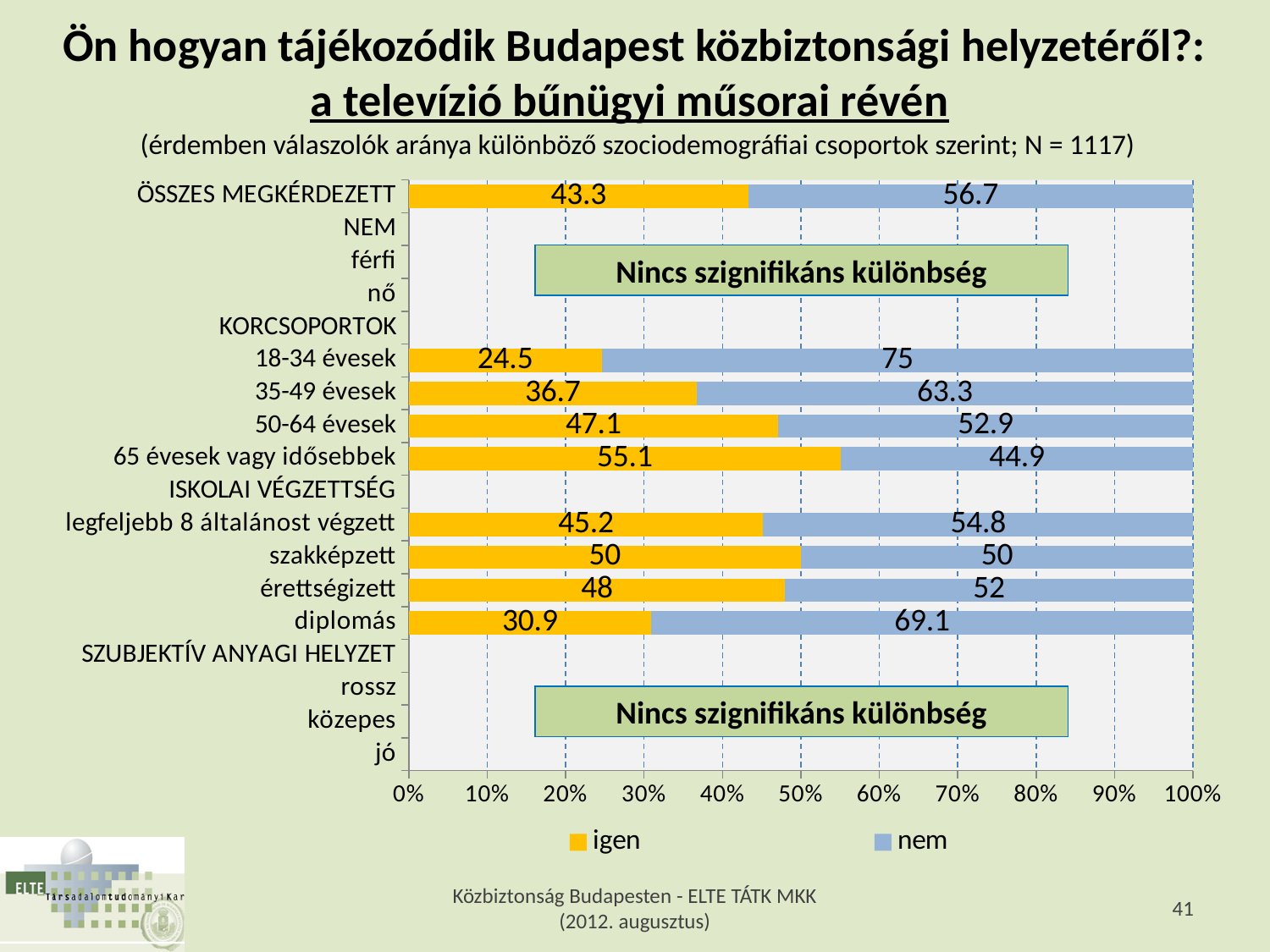
How many series does the legend list? 2 What is the "igen" value for ÖSSZES MEGKÉRDEZETT? 43.3 What is the "igen" value for diplomás? 30.9 Which is larger: the "igen" value for szakképzett or the "igen" value for érettségizett? szakképzett What kind of chart is shown on the slide? Stacked bar chart Among the education groups (ISKOLAI VÉGZETTSÉG), which has the lowest "igen" value? diplomás Is the "igen" value for 50-64 évesek greater or less than 40%? greater What is the "nem" value for 18-34 évesek? 75 What is the difference between the "nem" values for 18-34 évesek and 35-49 évesek? 11.7 What is the "nem" value for 65 évesek vagy idősebbek? 44.9 Among the age groups (KORCSOPORTOK), which has the highest "igen" value? 65 évesek vagy idősebbek What text appears in the green boxes covering the NEM and SZUBJEKTÍV ANYAGI HELYZET sections? Nincs szignifikáns különbség